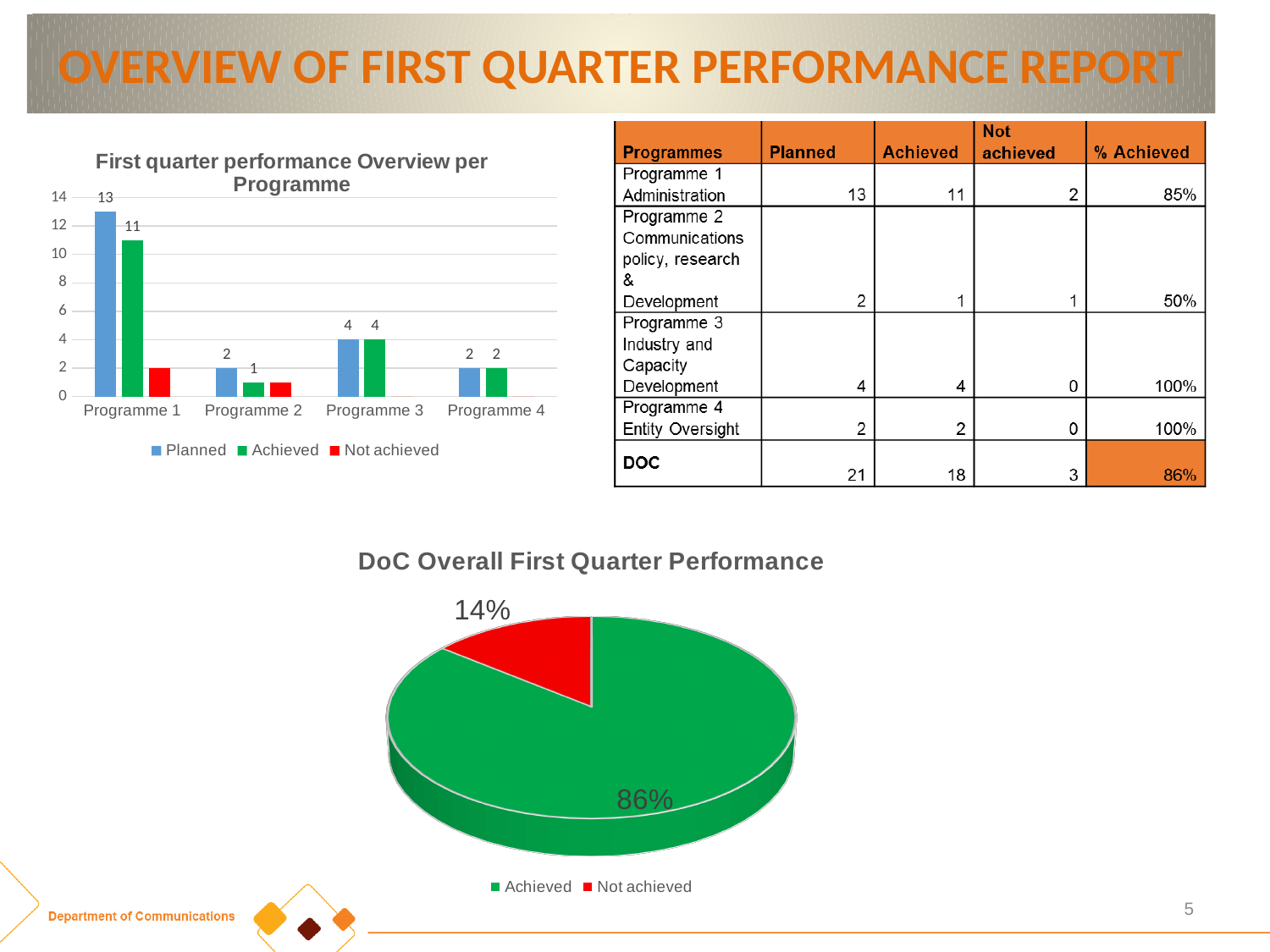
In the bar chart 'First quarter performance Overview per Programme', what is the difference between the Planned and Achieved values for Programme 1? 2 In the bar chart 'First quarter performance Overview per Programme', what is the Planned value for Programme 3? 4 In the bar chart 'First quarter performance Overview per Programme', what is the Achieved value for Programme 1? 11 In the bar chart 'First quarter performance Overview per Programme', how many programmes are shown on the x axis? 4 In the bar chart 'First quarter performance Overview per Programme', which programme has the highest Planned value? Programme 1 In the bar chart 'First quarter performance Overview per Programme', what is the Planned value for Programme 1? 13 In the bar chart 'First quarter performance Overview per Programme', what is the Achieved value for Programme 2? 1 In the pie chart 'DoC Overall First Quarter Performance', what share is Achieved? 86% What kind of chart is 'DoC Overall First Quarter Performance'? Pie chart In the bar chart 'First quarter performance Overview per Programme', is the Planned value for Programme 3 larger than the Planned value for Programme 4? Yes In the bar chart 'First quarter performance Overview per Programme', how many series does the legend list? 3 In the pie chart 'DoC Overall First Quarter Performance', what share is Not achieved? 14%